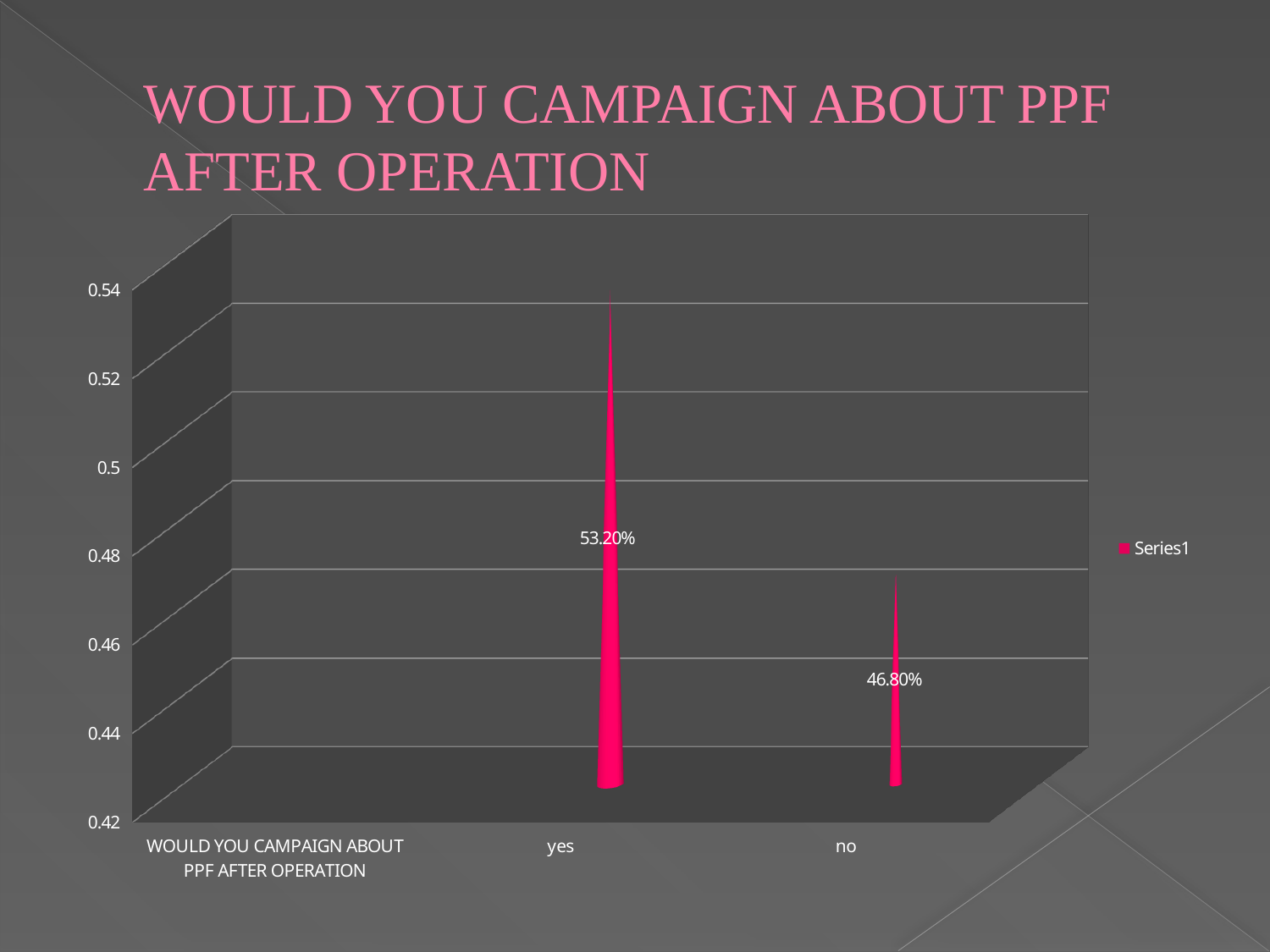
Which category has the lowest value? no Is the value for "yes" greater or less than 0.5? greater What is the difference between the values for "yes" and "no"? 6.40% What is the value for "yes"? 53.20% What kind of chart is shown on the slide? bar chart What is the value for "no"? 46.80% How many bars are plotted on the chart? 2 Which is larger, the value for "yes" or the value for "no"? yes How many series does the legend list? 1 Is the value for "no" greater or less than 0.48? less What is the name of the series shown in the legend? Series1 Which category has the highest value? yes